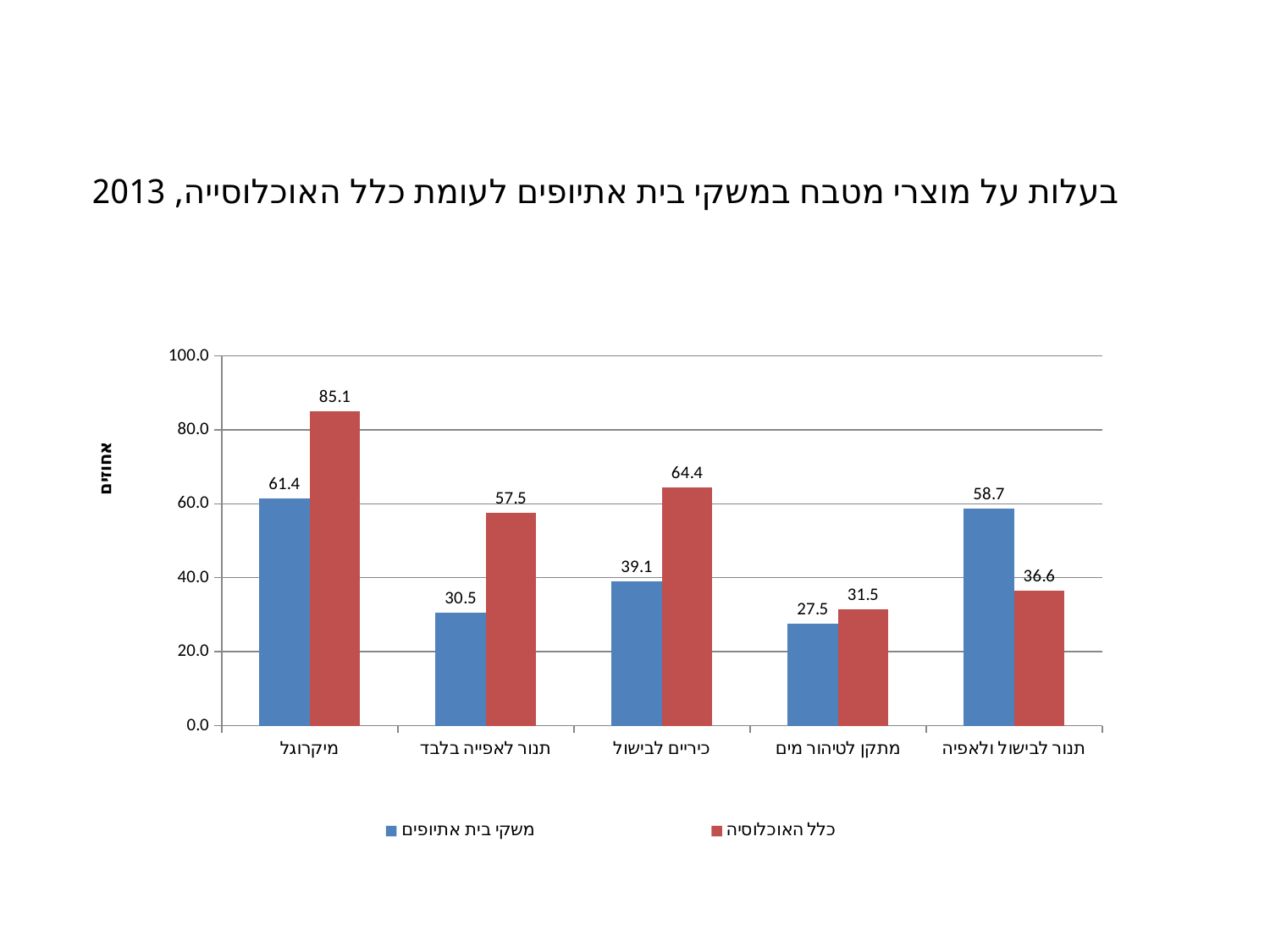
What is the value for כלל האוכלוסיה in the תנור לאפייה בלבד category? 57.5 Which category has the lowest value for משקי בית אתיופים? מתקן לטיהור מים What is the value for משקי בית אתיופים in the מתקן לטיהור מים category? 27.5 In the תנור לבישול ולאפיה category, which series has the larger value, משקי בית אתיופים or כלל האוכלוסיה? משקי בית אתיופים What is the label of the y axis? אחוזים Is the value for כלל האוכלוסיה in the מיקרוגל category greater or less than 80.0? greater What kind of chart is shown on the slide? bar chart How many series does the legend list? 2 How many categories are shown on the x axis? 5 Which category has the highest value for כלל האוכלוסיה? מיקרוגל What is the value for משקי בית אתיופים in the מיקרוגל category? 61.4 What is the difference between כלל האוכלוסיה and משקי בית אתיופים in the כיריים לבישול category? 25.3